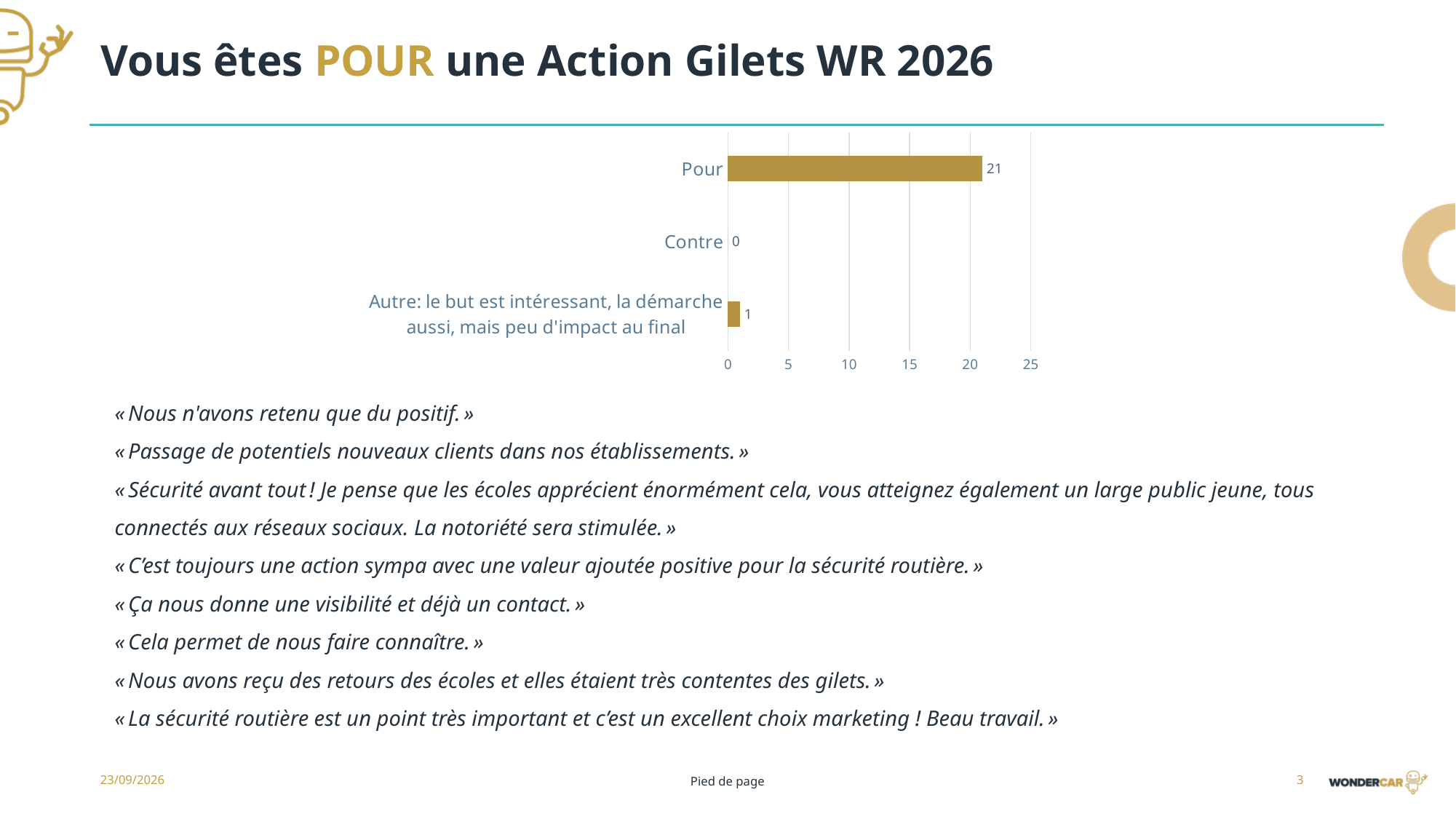
What is the highest value shown on the x axis of the chart? 25 What is the value for Contre? 0 Which is larger, the value for Pour or the value for Contre? Pour What is the total of all three values in the chart? 22 What is the value for Pour? 21 How many categories are shown in the chart? 3 Which category has the lowest value? Contre Is the value for Pour greater or less than 20? greater What is the value for the category 'Autre: le but est intéressant, la démarche aussi, mais peu d'impact au final'? 1 Which category has the highest value? Pour What is the difference between the values for Pour and Autre? 20 What kind of chart is shown on the slide? bar chart